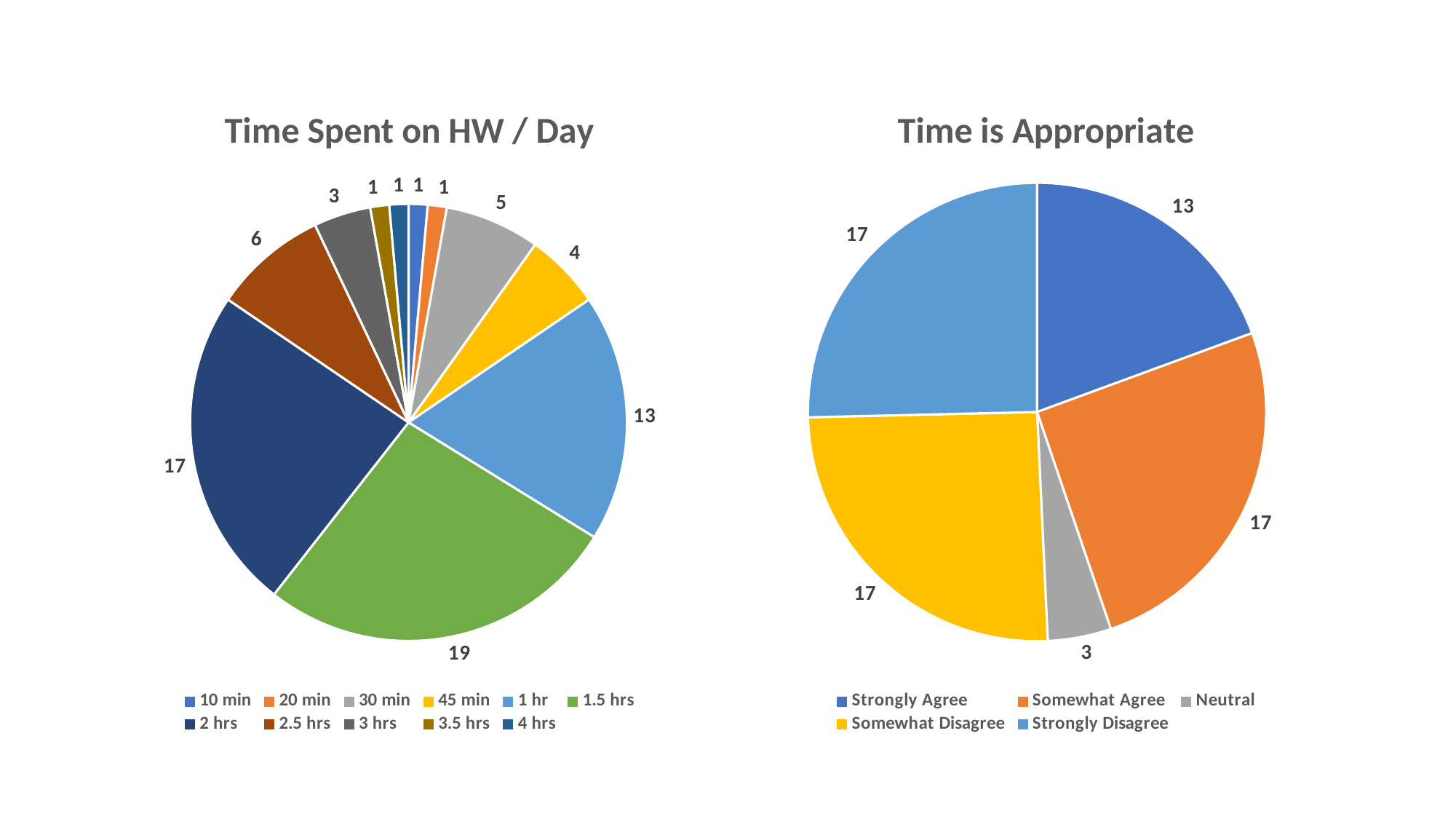
How many categories does the "Time Spent on HW / Day" chart show? 11 How many categories does the "Time is Appropriate" chart show? 5 What kind of chart is "Time Spent on HW / Day"? pie chart In the "Time Spent on HW / Day" chart, what is the difference between the values for 1.5 hrs and 2 hrs? 2 In the "Time Spent on HW / Day" chart, what is the value for 2.5 hrs? 6 In the "Time is Appropriate" chart, which category has the smallest slice? Neutral In the "Time is Appropriate" chart, what is the value for Neutral? 3 In the "Time Spent on HW / Day" chart, which is larger, 30 min or 45 min? 30 min What is the total of all slices in the "Time is Appropriate" chart? 67 In the "Time Spent on HW / Day" chart, what is the value for 1 hr? 13 In the "Time Spent on HW / Day" chart, which category has the largest slice? 1.5 hrs In the "Time is Appropriate" chart, what is the difference between the values for Somewhat Agree and Strongly Agree? 4